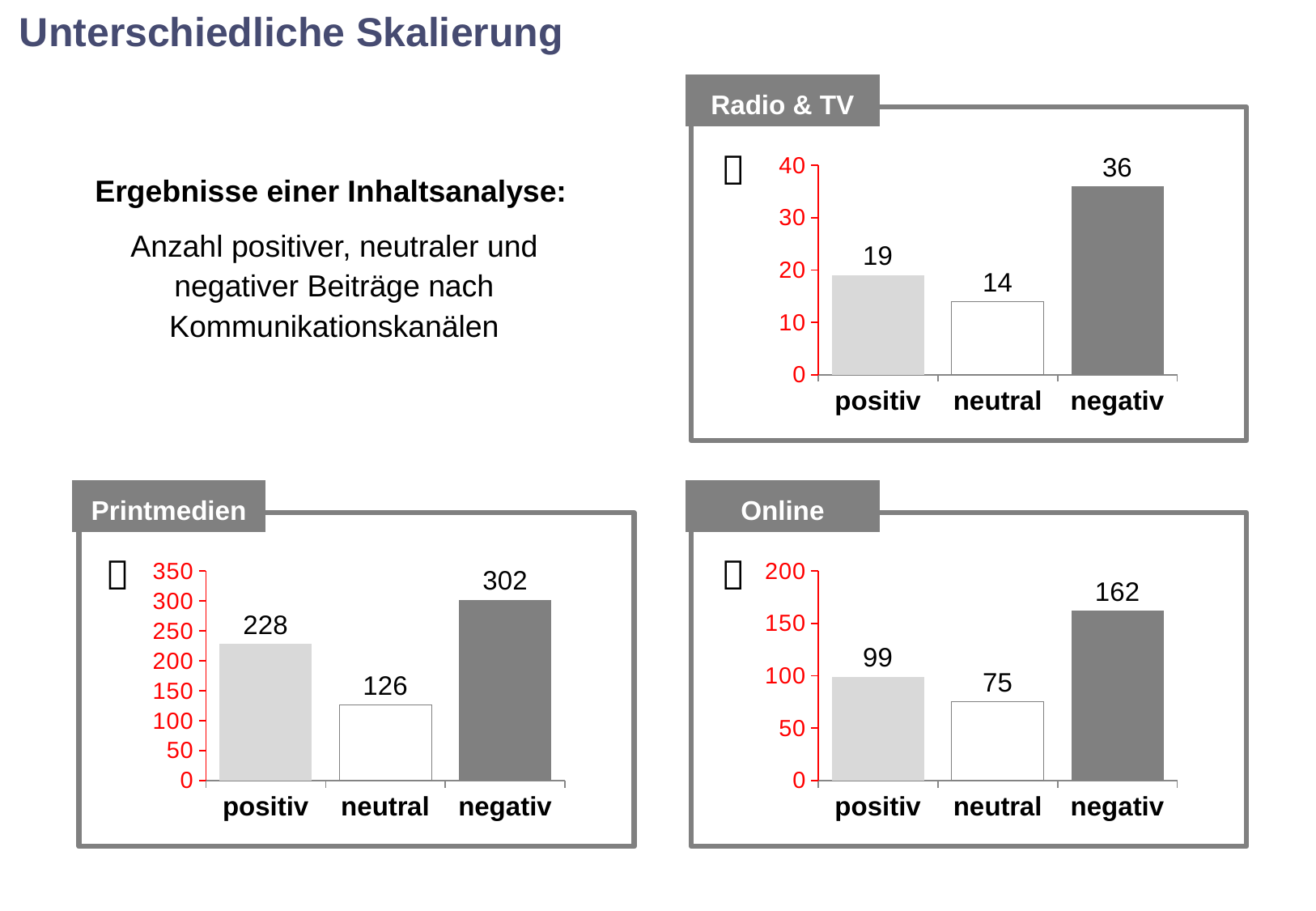
In the Radio & TV chart, what is the difference between the values for negativ and positiv? 17 In the Radio & TV chart, is the value for neutral greater or less than 20? less In the Printmedien chart, what is the value for neutral? 126 How many categories are shown in the Online chart? 3 In the Online chart, which is larger, the value for positiv or the value for neutral? positiv What is the highest value shown on the y axis of the Printmedien chart? 350 What kind of chart is the Printmedien chart? bar chart In the Printmedien chart, what is the difference between the values for negativ and neutral? 176 In the Online chart, what is the value for positiv? 99 In the Printmedien chart, which category has the highest value? negativ In the Online chart, which category has the lowest value? neutral In the Radio & TV chart, what is the value for negativ? 36